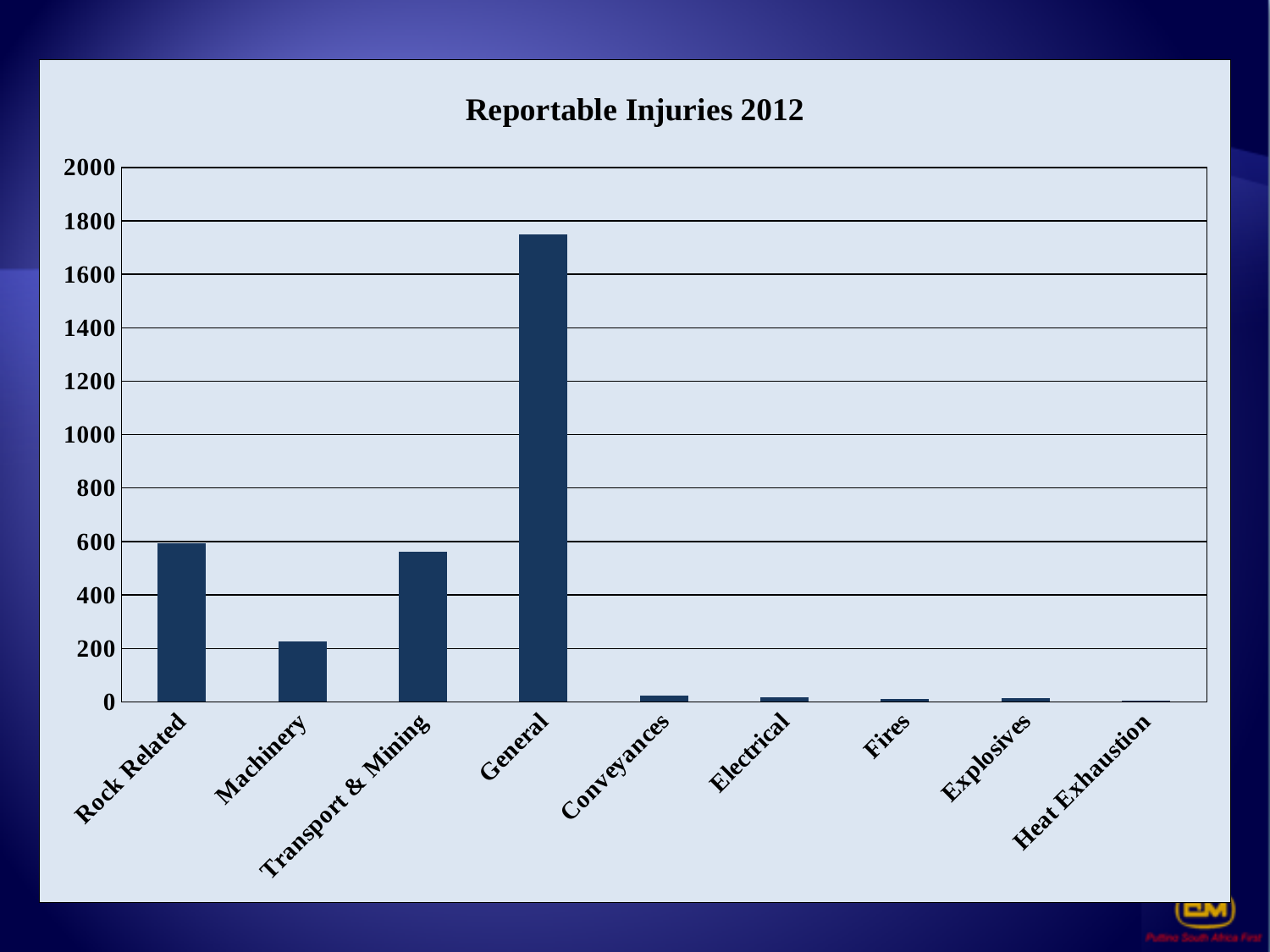
Is the value for General greater or less than 1600? greater Which category has the highest number of reportable injuries? General How many categories are shown on the x axis of the chart? 9 Which is larger, the value for General or the value for Transport & Mining? General Is the value for Transport & Mining greater or less than 600? less Which is larger, the value for Rock Related or the value for Machinery? Rock Related What type of chart is shown on the slide? bar chart Is the value for Rock Related greater or less than 400? greater What is the title of the chart? Reportable Injuries 2012 Which is larger, the value for Machinery or the value for Electrical? Machinery